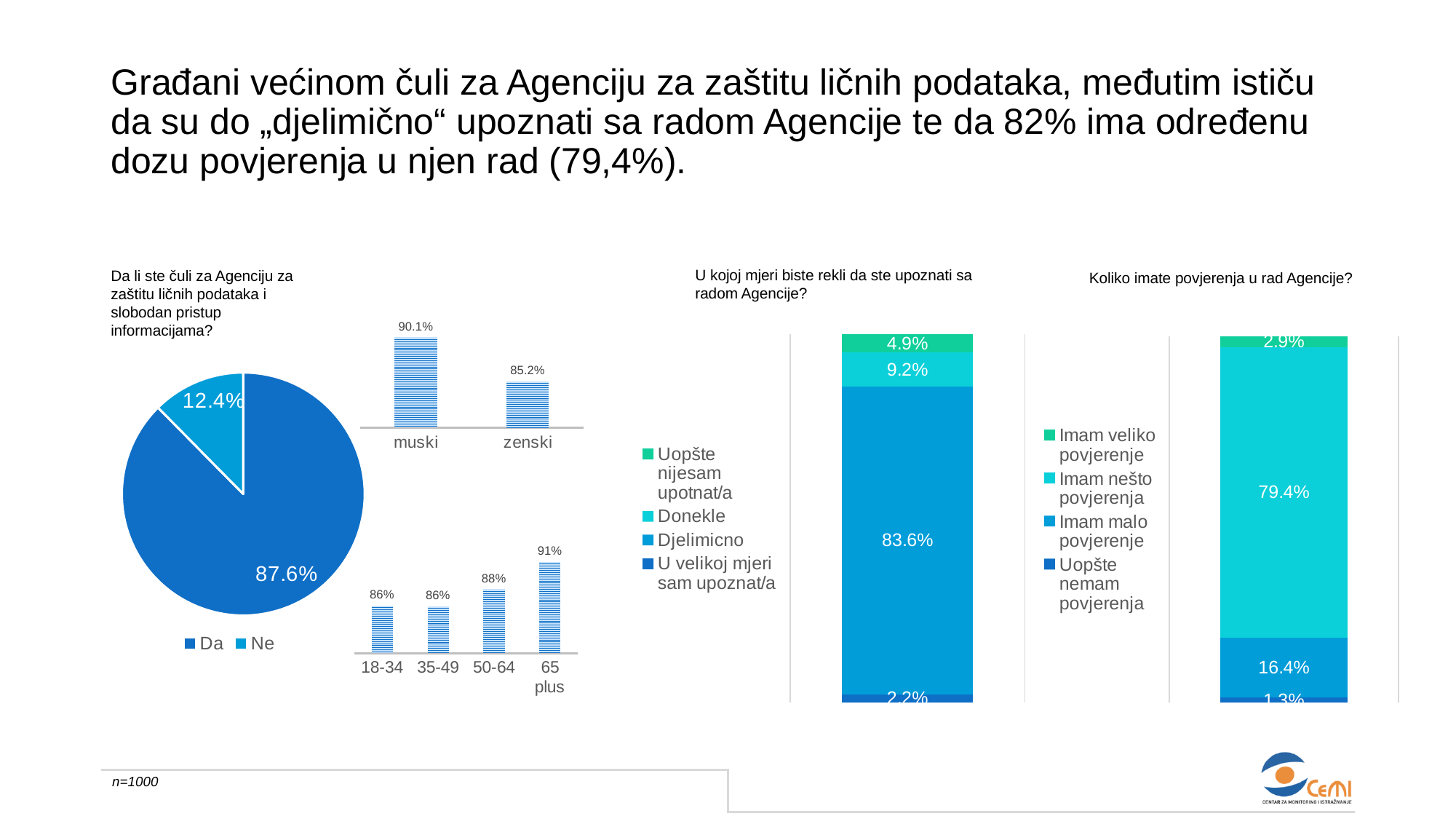
In the bar chart by age group, what is the value for '50-64'? 88% In the pie chart 'Da li ste čuli za Agenciju za zaštitu ličnih podataka i slobodan pristup informacijama?', what share of respondents answered 'Da'? 87.6% In the stacked bar chart 'Koliko imate povjerenja u rad Agencije?', which of 'Imam malo povjerenje' or 'Imam veliko povjerenje' has the larger value? Imam malo povjerenje In the pie chart 'Da li ste čuli za Agenciju...', what share of respondents answered 'Ne'? 12.4% In the pie chart on the left, how many slices are there? 2 In the stacked bar chart 'Koliko imate povjerenja u rad Agencije?', what is the value for 'Imam nešto povjerenja'? 79.4% In the small bar chart by gender (muski / zenski), what is the value for 'muski'? 90.1% In the stacked bar chart 'U kojoj mjeri biste rekli da ste upoznati sa radom Agencije?', what is the value for 'Djelimicno'? 83.6% In the bar chart by age group (18-34, 35-49, 50-64, 65 plus), which age group has the highest value? 65 plus In the small bar chart by gender, what is the difference between the values for 'muski' and 'zenski'? 4.9% In the bar chart by age group, how many age groups are shown? 4 In the stacked bar chart 'U kojoj mjeri biste rekli da ste upoznati sa radom Agencije?', how many entries does the legend list? 4